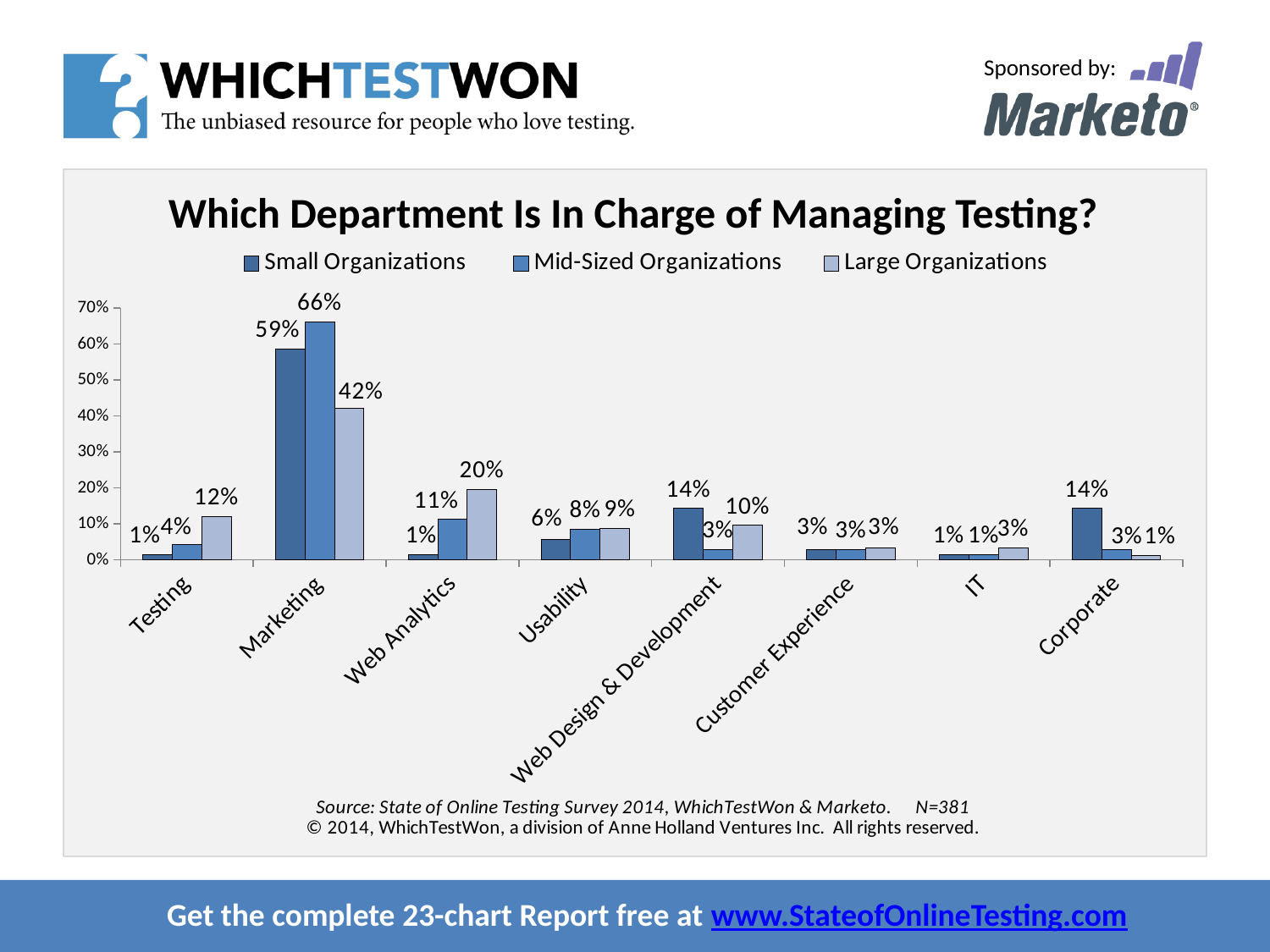
What is the value for Mid-Sized Organizations in the Marketing category? 66% Which department has the lowest value for Large Organizations? Corporate Is the Small Organizations value for Marketing greater or less than 50%? greater Which department has the highest value for Small Organizations? Marketing What is the difference between the Mid-Sized Organizations and Large Organizations values for Marketing? 24% What is the value for Small Organizations in the Corporate category? 14% What kind of chart is shown on the slide? Bar chart What is the value for Large Organizations in the Web Analytics category? 20% What is the title of the chart? Which Department Is In Charge of Managing Testing? How many series does the legend list? 3 How many departments are shown on the x axis? 8 Which is larger for Web Design & Development: the Small Organizations value or the Large Organizations value? Small Organizations